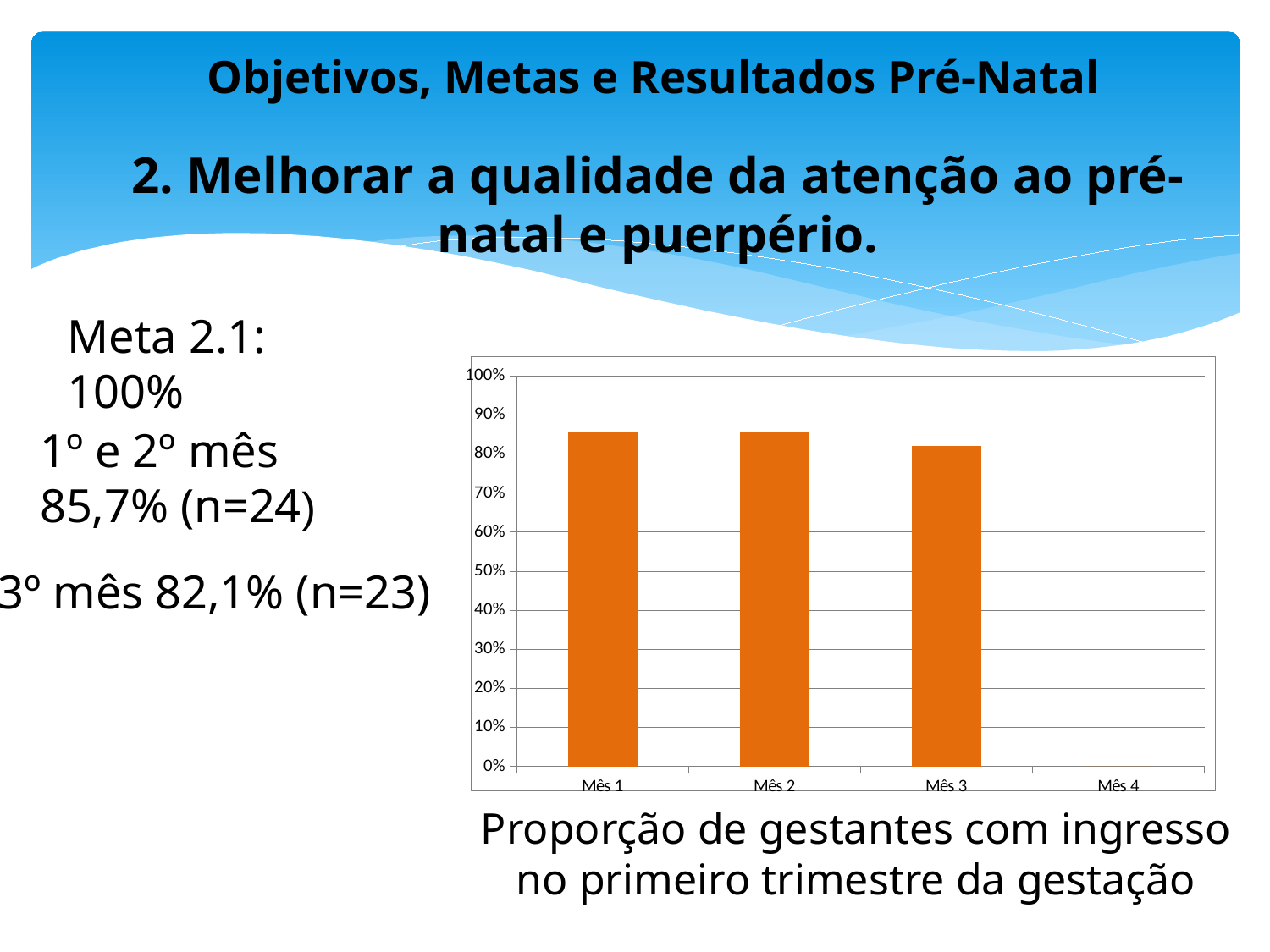
Which is larger, the value for Mês 2 or the value for Mês 3? Mês 2 Which x-axis category has no visible bar? Mês 4 What is the title shown below the chart? Proporção de gestantes com ingresso no primeiro trimestre da gestação What is the highest value shown on the y axis of the chart? 100% How many bars are visible in the chart? 3 Is the value for Mês 2 greater or less than 90%? less Is the value for Mês 3 greater or less than 70%? greater What kind of chart is shown on the slide? bar chart Is the value for Mês 1 greater or less than 80%? greater Which is larger, the value for Mês 1 or the value for Mês 3? Mês 1 How many categories are labelled on the x axis of the chart? 4